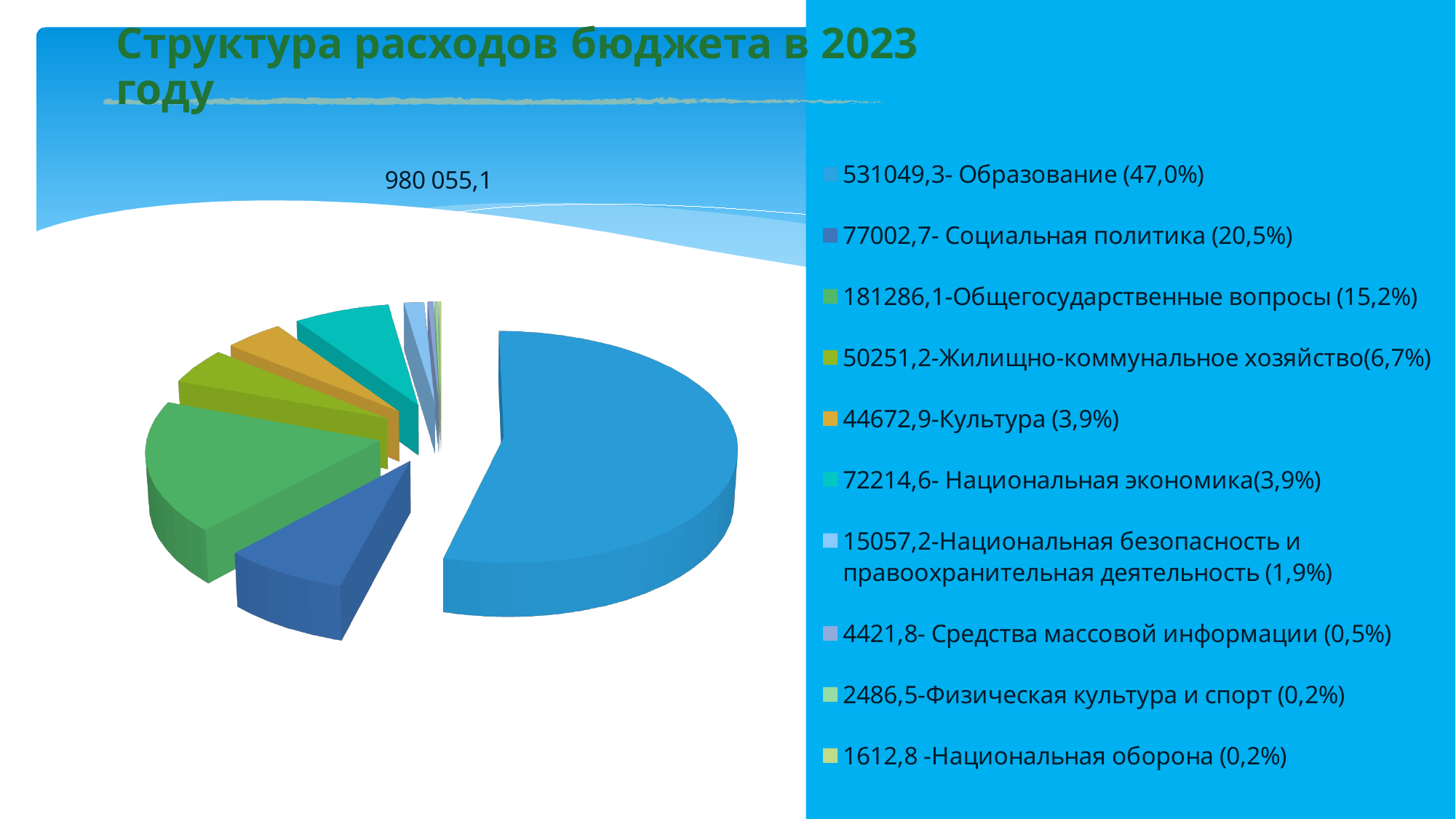
Which category has the largest share of the pie? Образование What percentage is shown for Средства массовой информации? 0,5% What share of the pie does Образование account for? 47,0% Which has the larger share: Образование or Социальная политика? Образование How many categories does the legend of the pie chart list? 10 What value is shown in the legend for Национальная оборона? 1612,8 What is the title of the slide? Структура расходов бюджета в 2023 году What value is shown in the legend for Культура? 44672,9 What percentage is shown for Жилищно-коммунальное хозяйство? 6,7% What kind of chart is shown on the slide? Pie chart What total value is printed above the pie chart? 980 055,1 What value is shown in the legend for Социальная политика? 77002,7